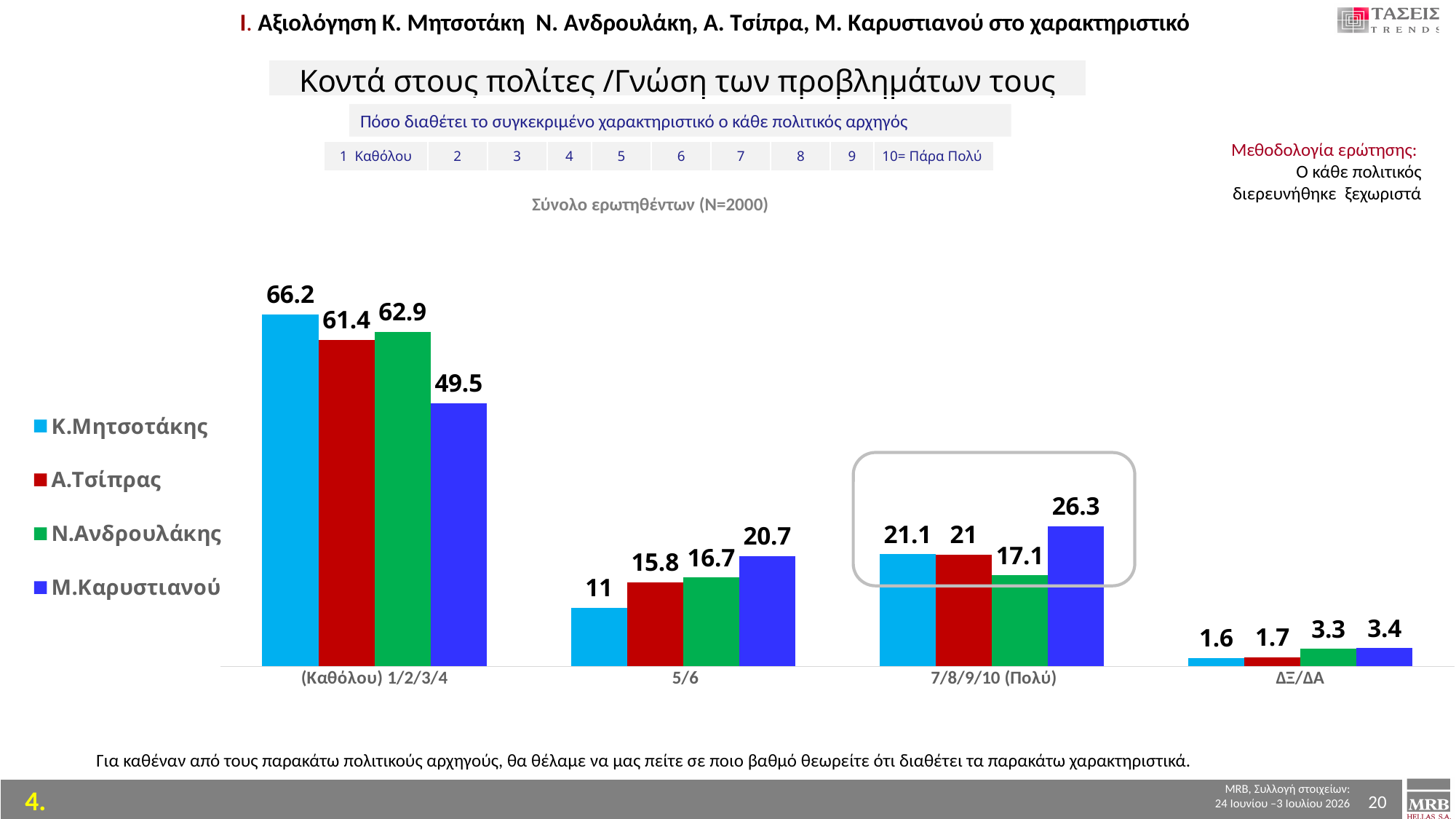
How many series does the legend list? 4 What is the value for Κ.Μητσοτάκης in the (Καθόλου) 1/2/3/4 category? 66.2 In the 5/6 category, which is larger: the value for Α.Τσίπρας or the value for Μ.Καρυστιανού? Μ.Καρυστιανού What kind of chart is shown on the slide? Bar chart How many categories are shown on the x axis of the chart? 4 Which series has the lowest value in the (Καθόλου) 1/2/3/4 category? Μ.Καρυστιανού What is the value for Μ.Καρυστιανού in the 7/8/9/10 (Πολύ) category? 26.3 What is the value for Α.Τσίπρας in the ΔΞ/ΔΑ category? 1.7 What is the value for Ν.Ανδρουλάκης in the 5/6 category? 16.7 Which series has the highest value in the 7/8/9/10 (Πολύ) category? Μ.Καρυστιανού What colour represents Ν.Ανδρουλάκης in the chart? Green What is the difference between the values for Κ.Μητσοτάκης and Μ.Καρυστιανού in the (Καθόλου) 1/2/3/4 category? 16.7